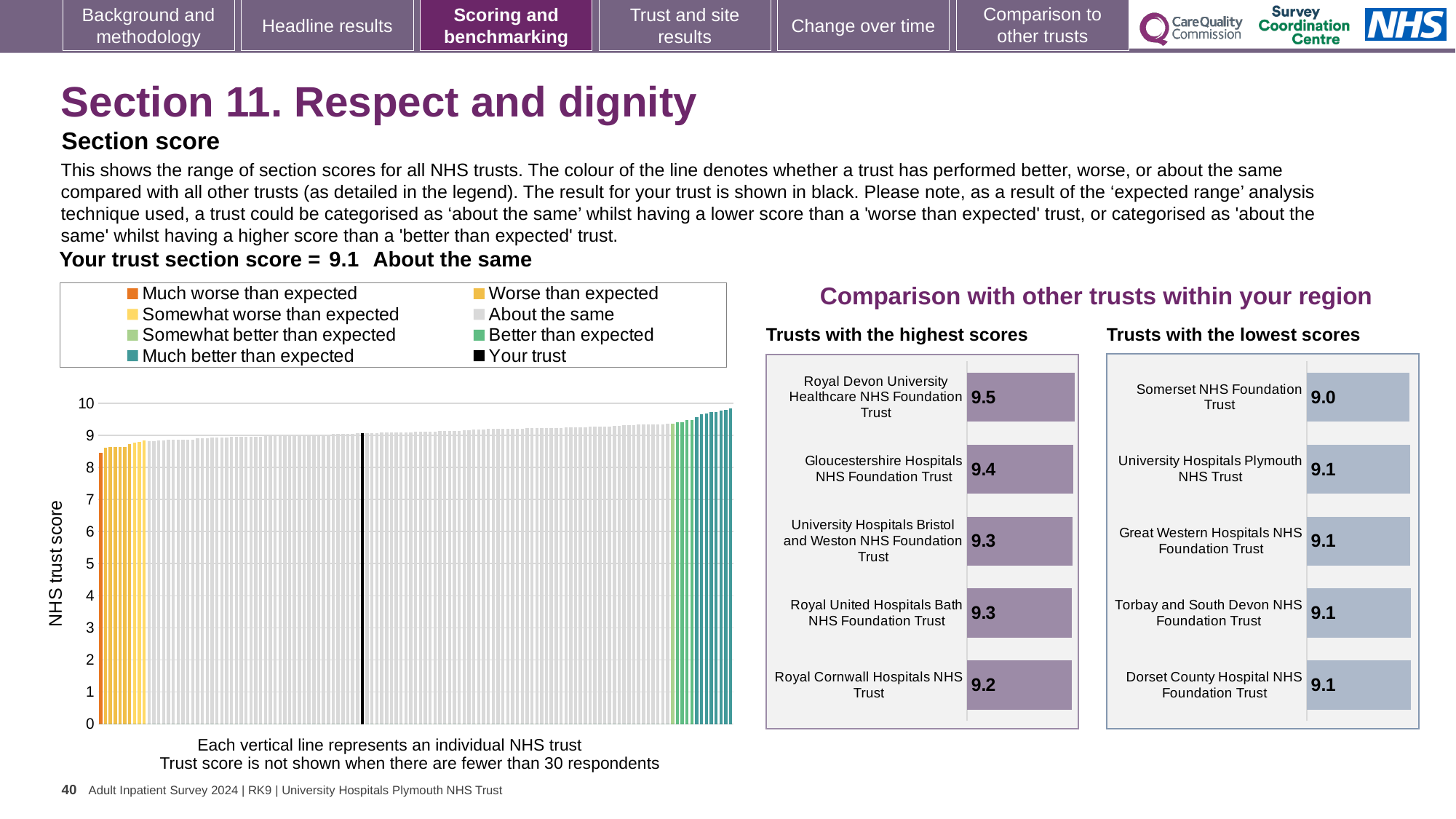
In the 'Trusts with the highest scores' chart, what is the score for Royal Devon University Healthcare NHS Foundation Trust? 9.5 How many entries does the legend of the large chart on the left list? 8 In the 'Trusts with the highest scores' chart, which trust has the highest score? Royal Devon University Healthcare NHS Foundation Trust In the 'Trusts with the lowest scores' chart, what is the difference between the scores of University Hospitals Plymouth NHS Trust and Somerset NHS Foundation Trust? 0.1 In the 'Trusts with the highest scores' chart, what is the difference between the scores of Royal Devon University Healthcare NHS Foundation Trust and Royal Cornwall Hospitals NHS Trust? 0.3 In the 'Trusts with the lowest scores' chart, what is the score for Somerset NHS Foundation Trust? 9.0 In the 'Trusts with the highest scores' chart, what is the score for Royal Cornwall Hospitals NHS Trust? 9.2 In the 'Trusts with the lowest scores' chart, which trust has the lowest score? Somerset NHS Foundation Trust In the 'Trusts with the highest scores' chart, which has the larger score: Gloucestershire Hospitals NHS Foundation Trust or Royal Cornwall Hospitals NHS Trust? Gloucestershire Hospitals NHS Foundation Trust In the large chart on the left, do the NHS trust scores rise or fall from left to right along the x axis? Rise What kind of chart is the large chart on the left showing NHS trust scores? Bar chart How many trusts are shown in the 'Trusts with the highest scores' chart? 5